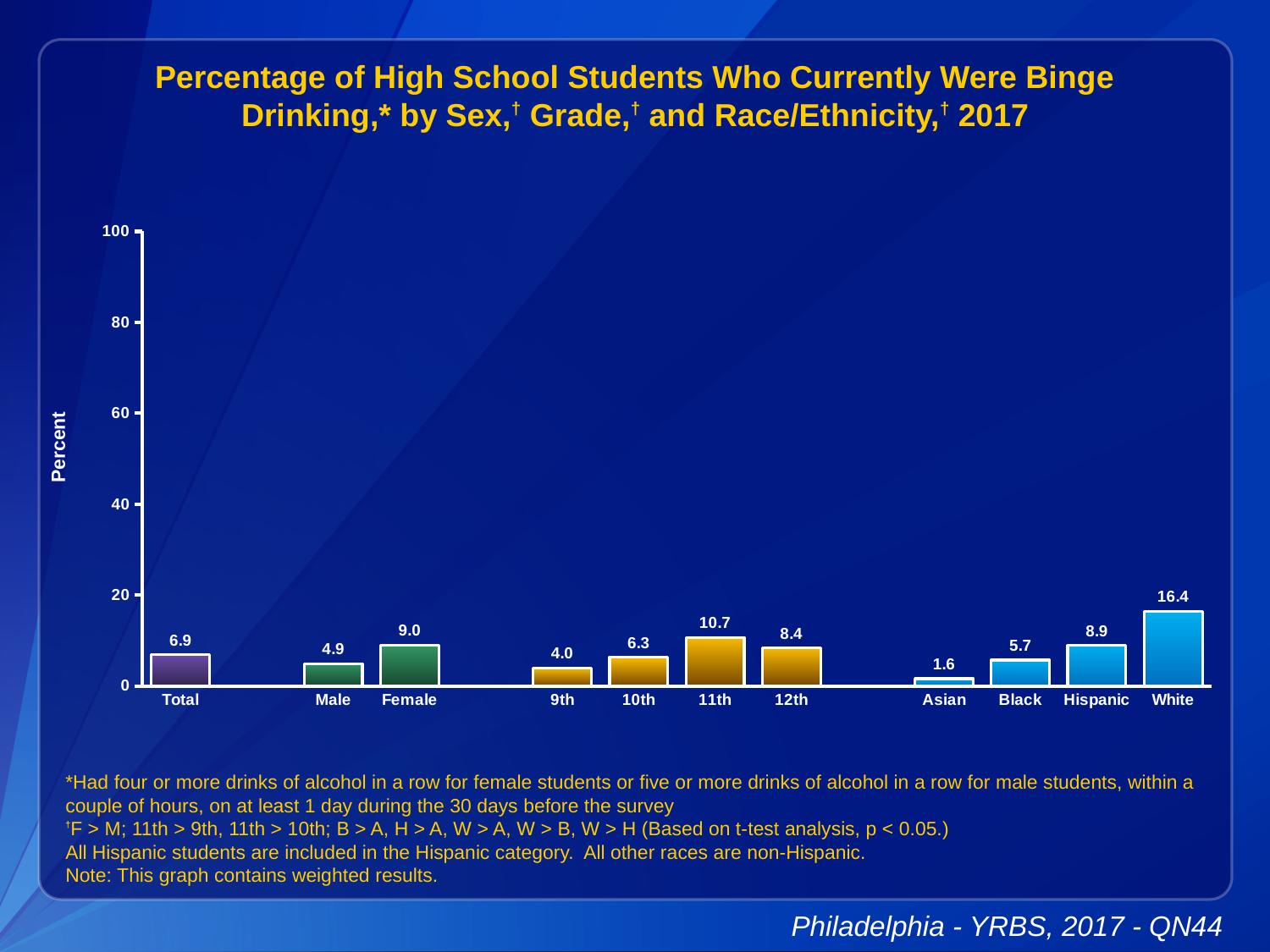
What is the label on the y axis? Percent How many categories are shown on the x axis? 11 What is the value for 11th grade? 10.7 What is the value for Female? 9.0 What is the difference between the values for Female and Male? 4.1 Which is larger, the value for Hispanic or the value for Black? Hispanic What is the value for Total? 6.9 What is the value for Asian? 1.6 What kind of chart is this? bar chart Which category has the highest value? White Which category has the lowest value? Asian Is the value for White greater or less than 20? less